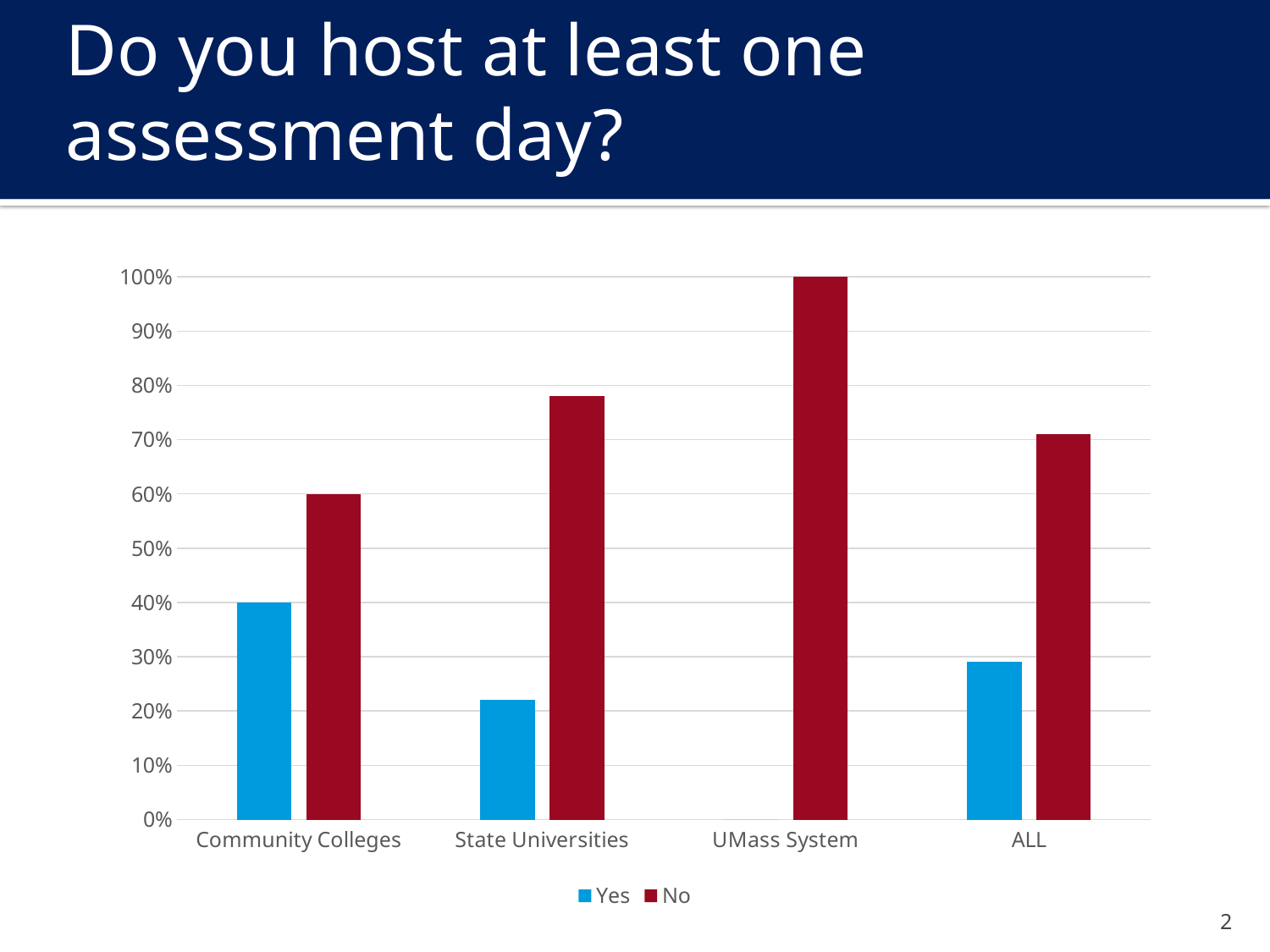
Which category has the lowest Yes value? UMass System What is the No value for Community Colleges? 60% Which category has the highest No value? UMass System How many categories are shown on the x axis? 4 Is the No value for State Universities greater or less than 70%? greater What kind of chart is shown on the slide? bar chart What is the No value for UMass System? 100% How many series does the legend list? 2 What colour are the No bars? dark red What is the Yes value for Community Colleges? 40% For State Universities, which is larger, the Yes value or the No value? No